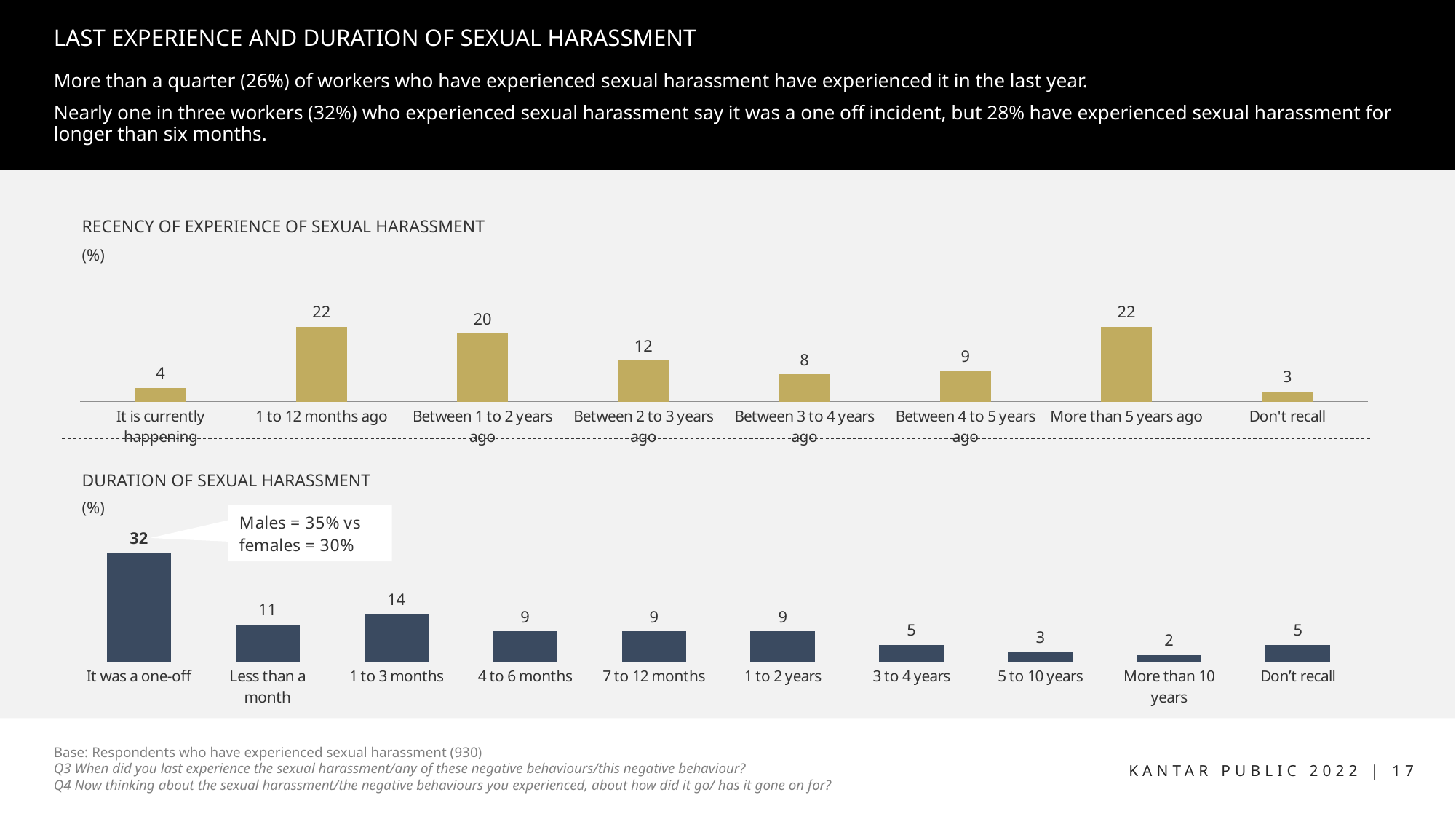
In the 'Duration of sexual harassment' chart, which is larger: 'Less than a month' or '1 to 3 months'? 1 to 3 months In the 'Recency of experience of sexual harassment' chart, what is the difference between 'Between 1 to 2 years ago' and 'Between 3 to 4 years ago'? 12 In the 'Recency of experience of sexual harassment' chart, what is the value for '1 to 12 months ago'? 22 In the 'Duration of sexual harassment' chart, what is the difference between 'It was a one-off' and 'Less than a month'? 21 In the 'Duration of sexual harassment' chart, what is the value for '1 to 3 months'? 14 In the 'Duration of sexual harassment' chart, what is the value for 'It was a one-off'? 32 What type of chart is the 'Duration of sexual harassment' chart? Bar chart In the 'Recency of experience of sexual harassment' chart, how many categories are shown? 8 In the 'Recency of experience of sexual harassment' chart, what is the value for 'Between 2 to 3 years ago'? 12 In the 'Recency of experience of sexual harassment' chart, which category has the lowest value? Don't recall In the 'Duration of sexual harassment' chart, which category has the lowest value? More than 10 years In the 'Duration of sexual harassment' chart, how many categories are shown? 10